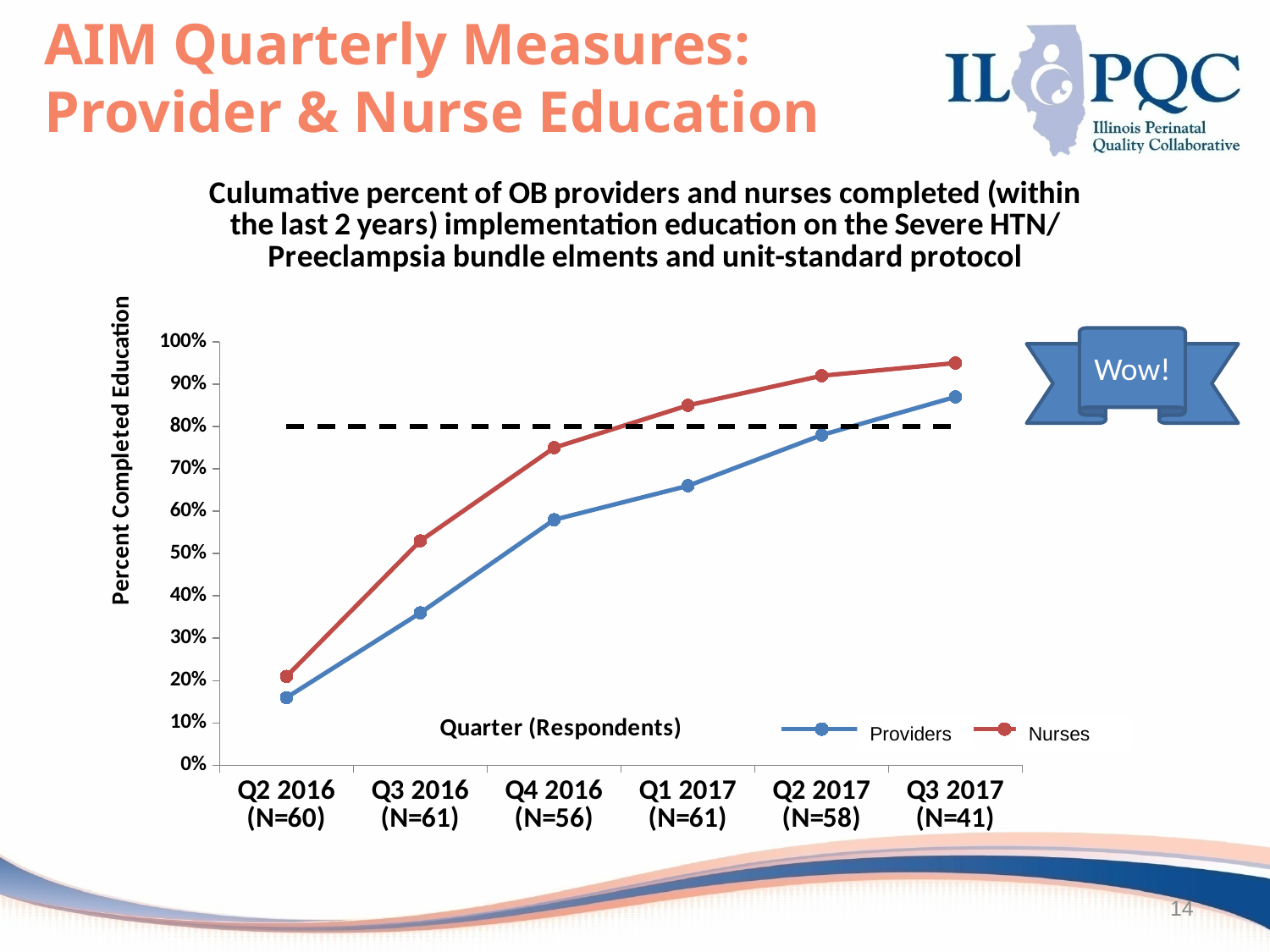
Is the Providers value for Q3 2017 greater or less than 80%? greater How many series does the legend list? 2 At what percentage level is the horizontal dashed line drawn? 80% How many quarters are plotted along the x axis? 6 Is the Nurses value for Q3 2016 greater or less than 40%? greater In which quarter is the Providers value lowest? Q2 2016 (N=60) What kind of chart is shown on the slide? line chart At Q4 2016, which series has the larger value, Providers or Nurses? Nurses Do the Providers values rise or fall from Q2 2016 to Q3 2017? rise In which quarter is the Nurses value highest? Q3 2017 (N=41) Is the Nurses value for Q3 2017 greater or less than 90%? greater